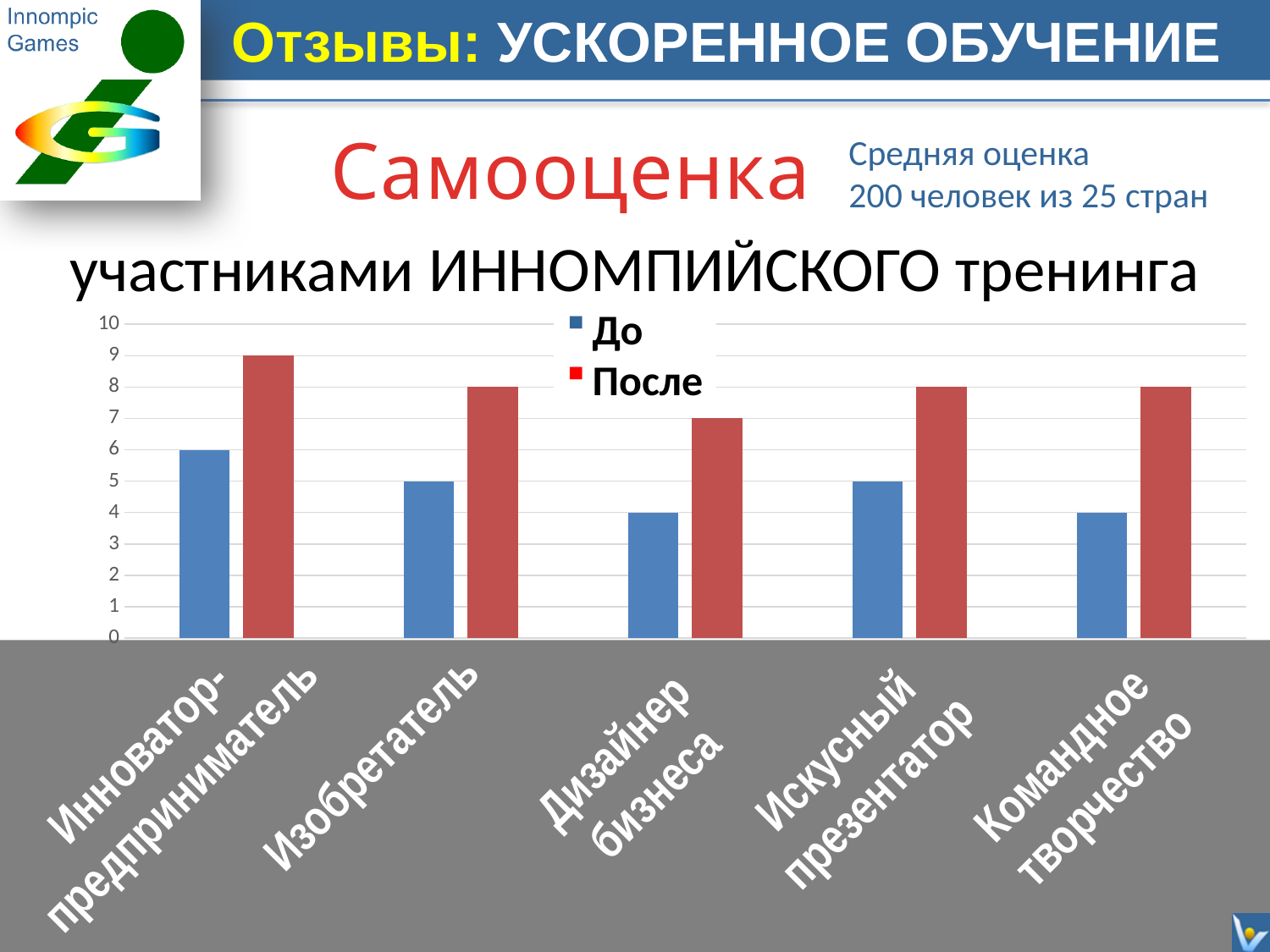
How many categories are shown on the x axis? 5 What is the difference between the "После" and "До" values for Изобретатель? 3 What is the value for "После" for Инноватор-предприниматель? 9 What are the two legend entries of the chart? До, После What is the value for "До" for Командное творчество? 4 What is the value for "После" for Дизайнер бизнеса? 7 What kind of chart is shown on the slide? bar chart What is the value for "До" for Инноватор-предприниматель? 6 How many series does the legend list? 2 Which category has the highest "После" value? Инноватор-предприниматель Which category has the lowest "После" value? Дизайнер бизнеса Which is larger for Искусный презентатор: the "До" value or the "После" value? После